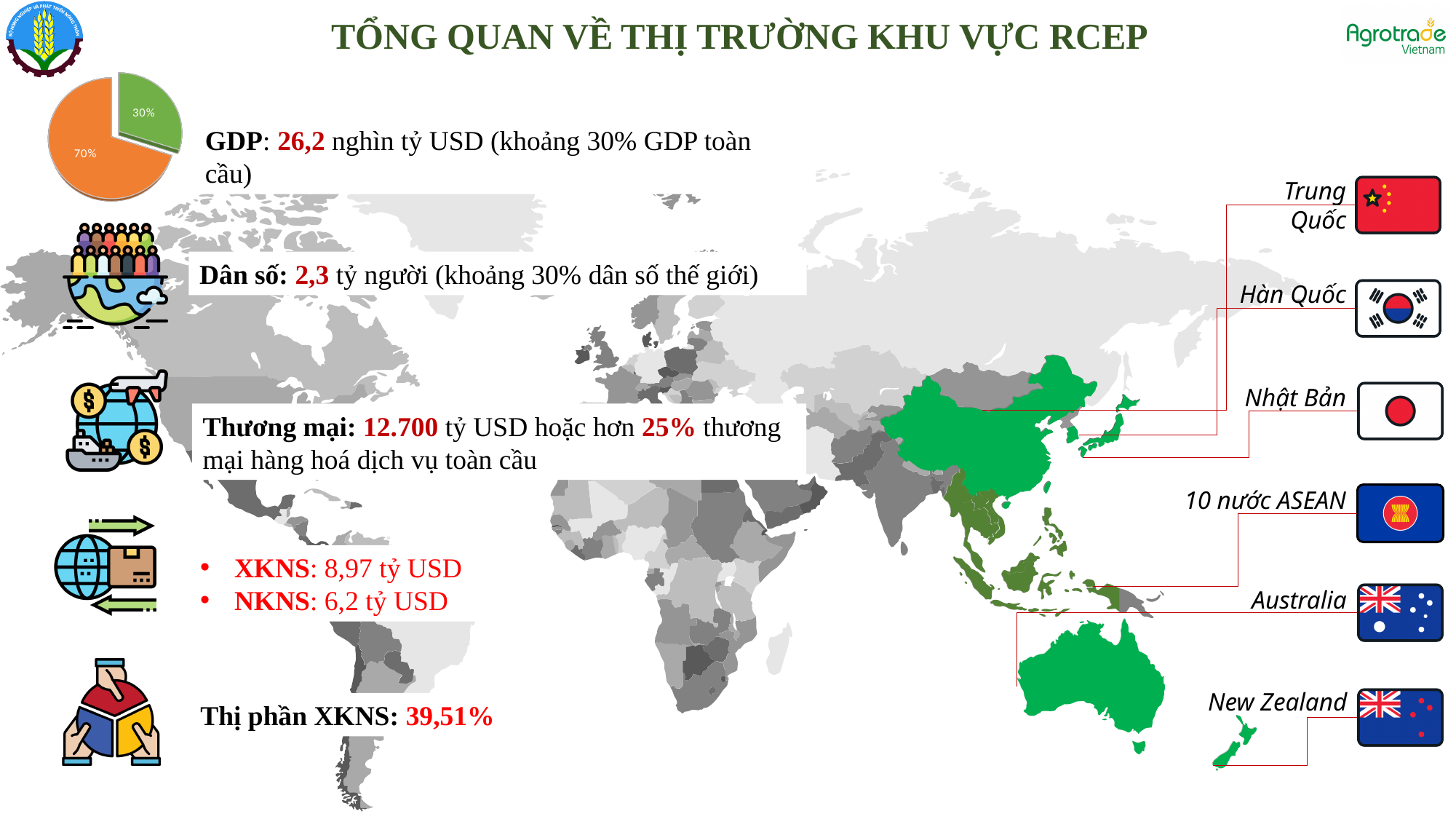
What percentage is shown on the green slice of the pie chart? 30% Which slice of the pie chart is pulled out (exploded) from the rest? the green 30% slice What do the two slices of the pie chart add up to? 100% Which slice of the pie chart is the smallest? the green slice (30%) What kind of chart is shown at the top left of the slide? pie chart Which slice of the pie chart is the largest? the orange slice (70%) What is the difference between the two slices of the pie chart? 40% How many slices does the pie chart at the top left have? 2 Is the orange slice of the pie chart larger or smaller than the green slice? larger What percentage is shown on the orange slice of the pie chart? 70%